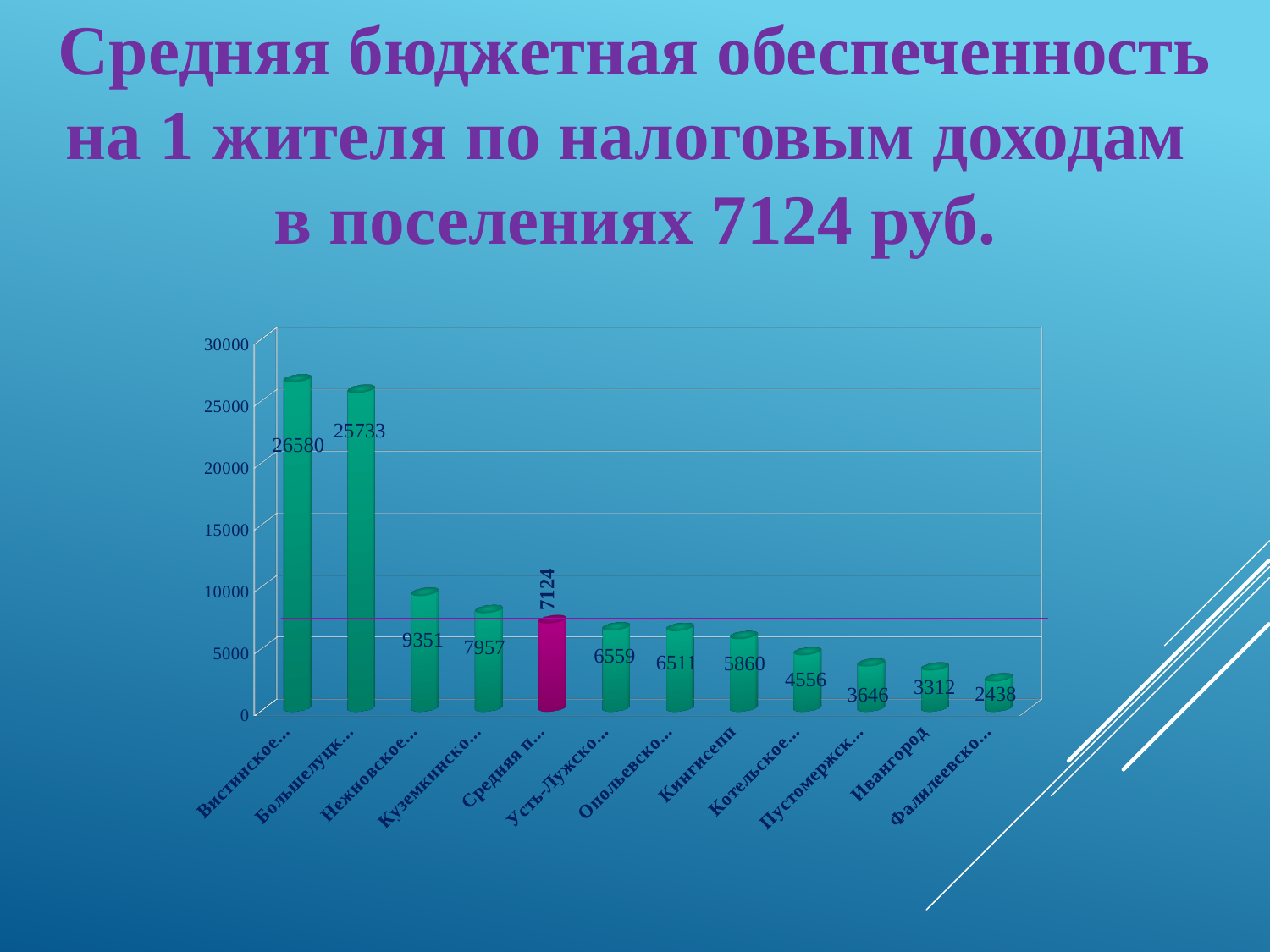
What value is labelled on the highlighted magenta bar (Средняя п...)? 7124 How many bars (categories) are shown in the chart? 12 Do the values rise or fall from left to right along the x axis? fall What kind of chart is shown on the slide? bar chart What is the difference between the values for Кингисепп and Ивангород? 2548 What is the value of the first (leftmost) bar, Вистинское? 26580 Which category has the highest value? Вистинское What is the value for Ивангород? 3312 Is the value for Кингисепп greater or less than 5000? greater Which category has the lowest value? Фалилеевско... (the last bar) Which is larger, the value for Кингисепп or the value for Ивангород? Кингисепп What is the value for Кингисепп? 5860